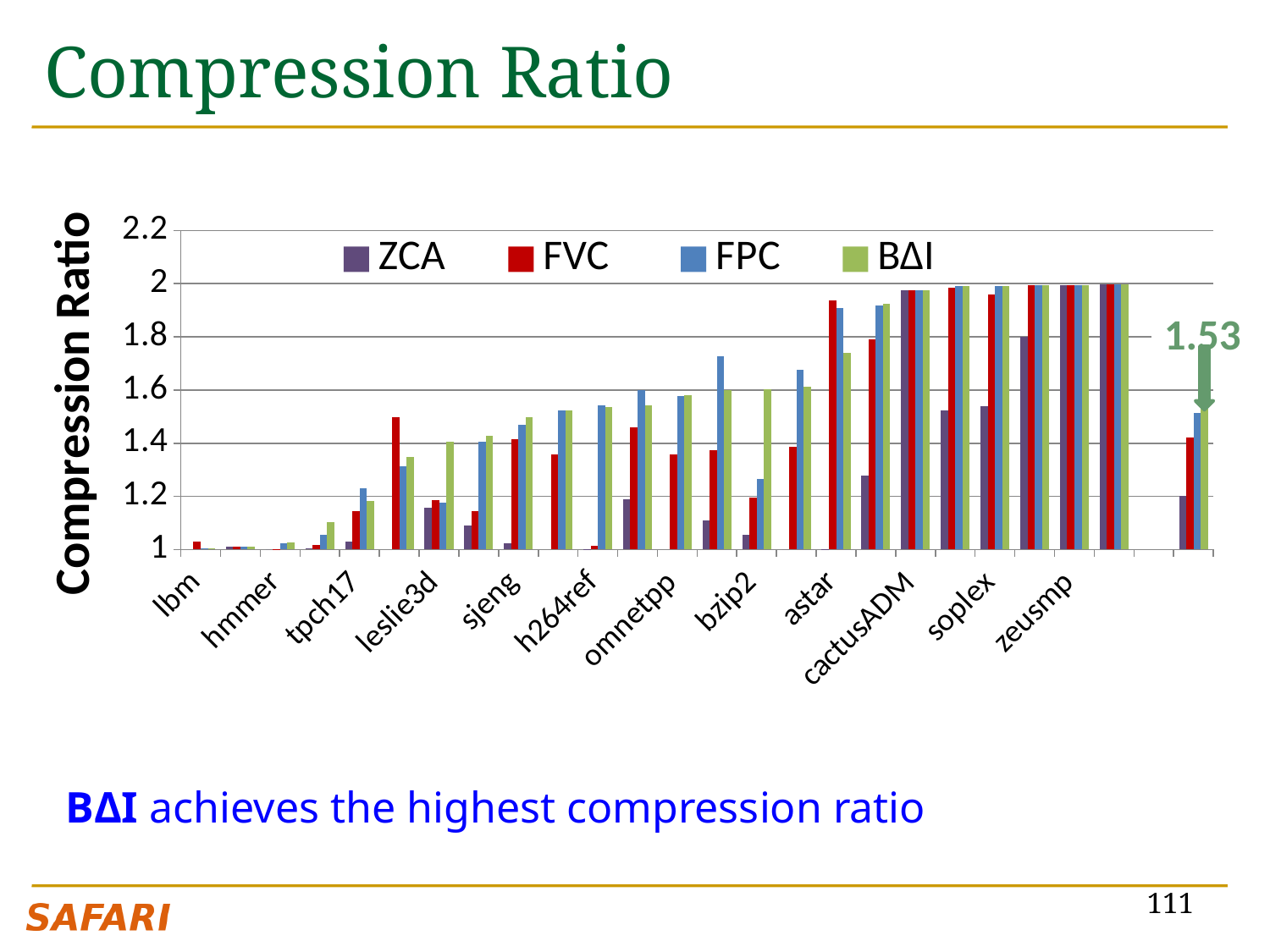
What are the four series named in the chart legend? ZCA, FVC, FPC, BΔI Do the BΔI values generally rise or fall from left to right across the benchmarks? rise What is the label on the vertical axis of the chart? Compression Ratio What is the highest value shown on the vertical axis of the chart? 2.2 How many series does the chart legend list? 4 Is the FVC value for zeusmp greater or less than 1.6? greater In the rightmost group of bars, which series has the highest value? BΔI What value is printed next to the arrow pointing at the rightmost group of bars? 1.53 Is the FVC value for lbm greater or less than 1.2? less In the rightmost group of bars, which is larger: the FVC value or the BΔI value? BΔI What kind of chart is shown on the slide? bar chart Is the BΔI value for zeusmp greater or less than 1.8? greater